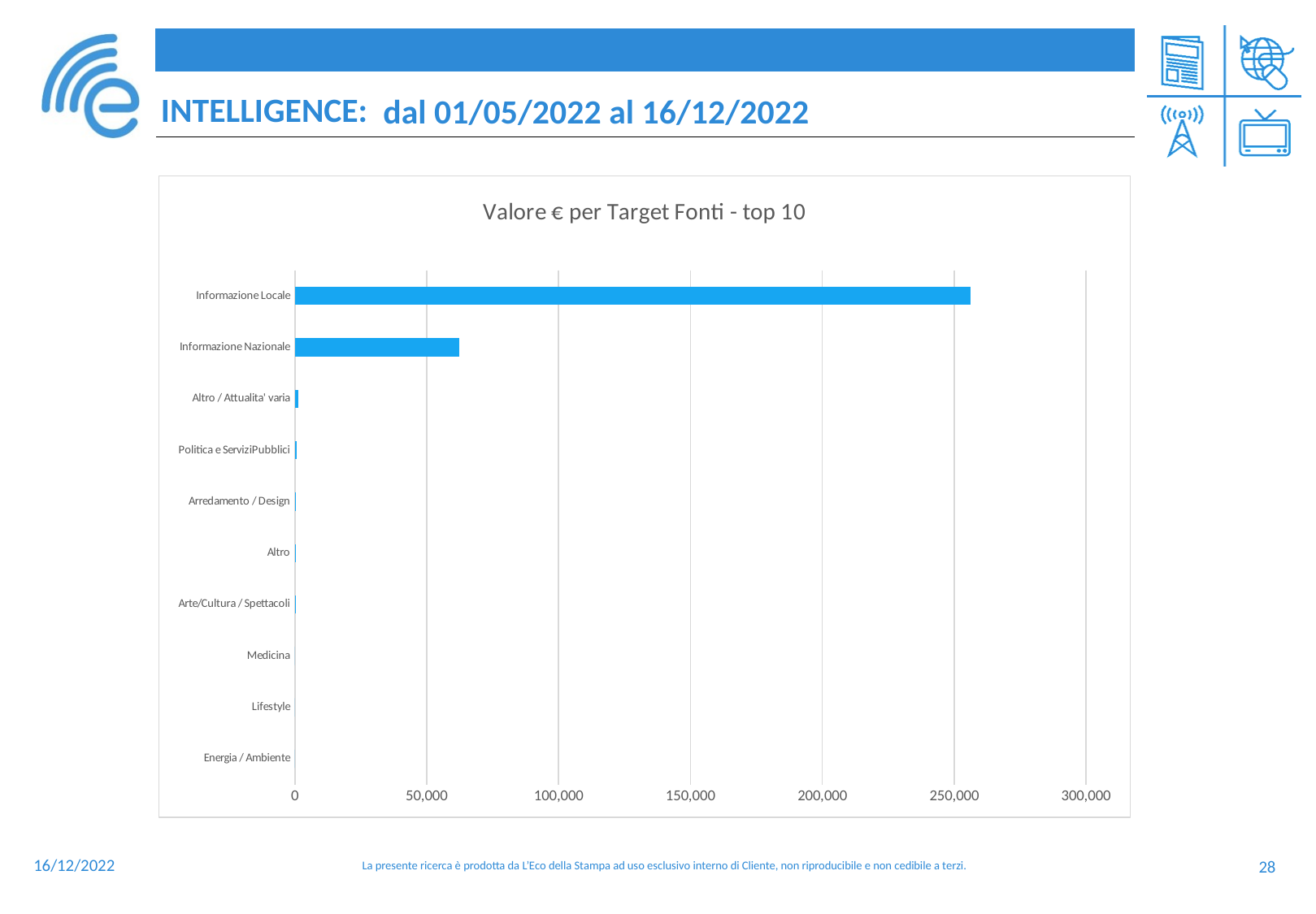
Is the value for Informazione Nazionale greater or less than 100,000? less What is the highest value shown on the horizontal axis? 300,000 Which category has the highest value? Informazione Locale Is the value for Informazione Locale greater or less than 200,000? greater Which is larger, the value for Informazione Nazionale or for Altro / Attualita' varia? Informazione Nazionale Which category is listed at the bottom of the chart? Energia / Ambiente What is the title of the chart? Valore € per Target Fonti - top 10 What kind of chart is shown on the slide? bar chart Is the value for Informazione Nazionale greater or less than 50,000? greater Which is larger, the value for Informazione Locale or for Informazione Nazionale? Informazione Locale How many categories are shown on the chart? 10